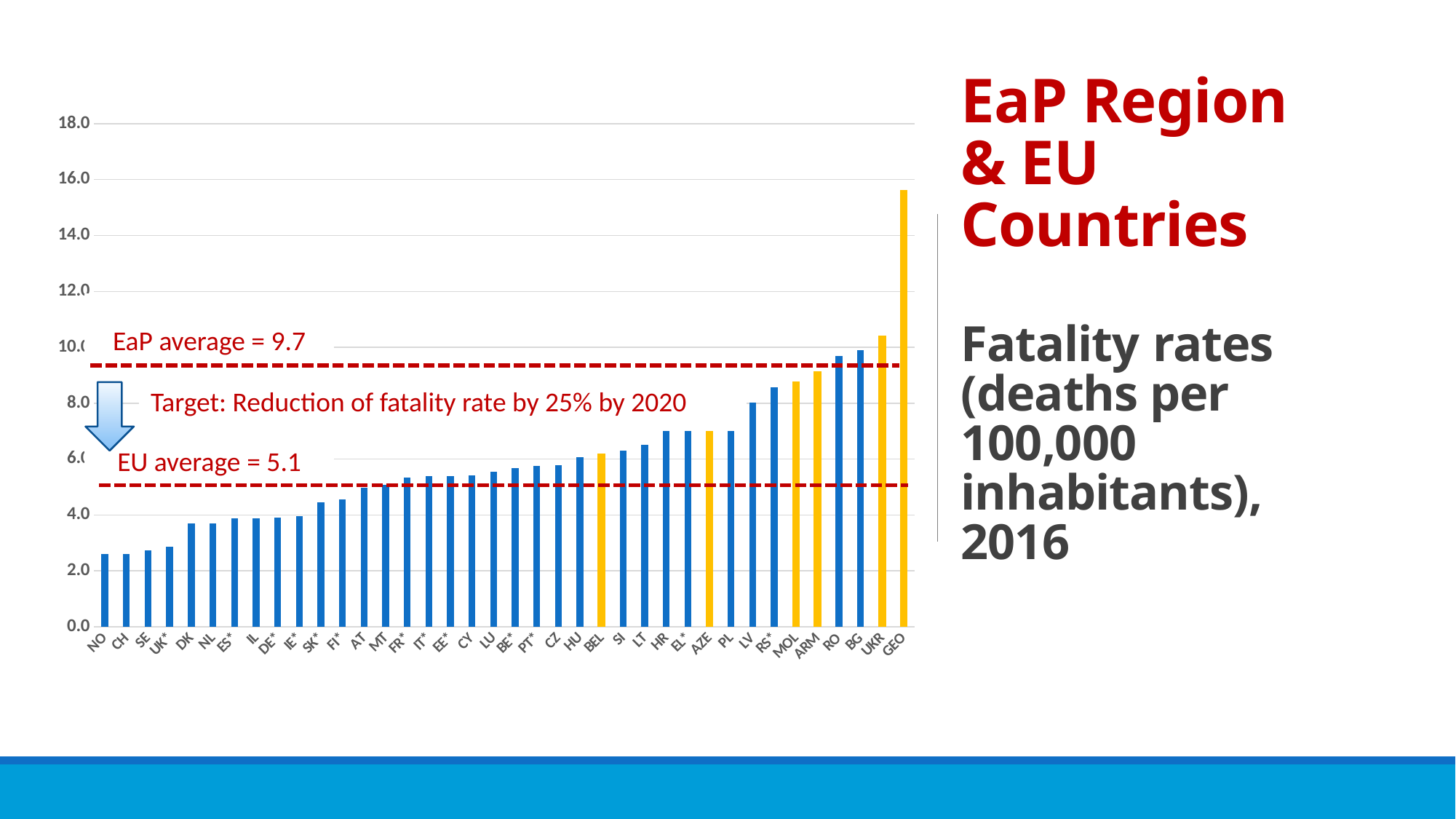
Which country has the highest fatality rate in the chart? GEO Is the fatality rate for GEO greater or less than 14.0? greater What is the difference between the EaP average and the EU average shown on the chart? 4.6 Is the fatality rate for NO greater or less than 4.0? less Do the fatality rates rise or fall moving from left to right along the x axis? rise What kind of chart is shown on the slide? bar chart What is the EaP average fatality rate shown on the chart? 9.7 Which has the higher fatality rate, UKR or GEO? GEO How many countries (bars) are shown in the chart? 38 Is the fatality rate for RO greater or less than 8.0? greater Which has the higher fatality rate, AZE or ARM? ARM